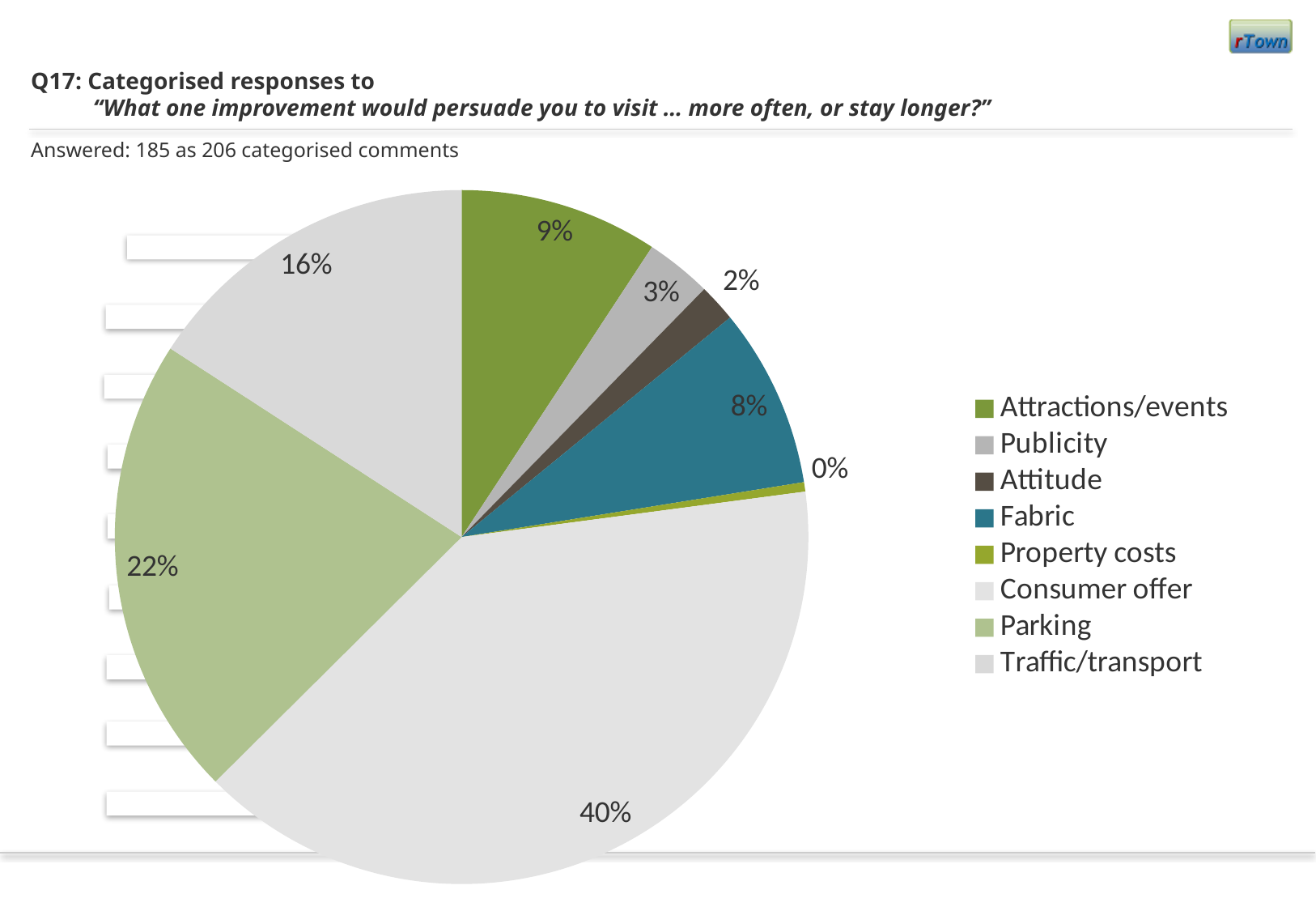
What is the combined share of Parking and Traffic/transport? 38% Which category has the largest slice of the pie? Consumer offer What percentage is shown for Fabric? 8% What is the difference in percentage points between Consumer offer and Parking? 18 What share of the pie does Consumer offer account for? 40% Which is larger, the share for Attractions/events or the share for Fabric? Attractions/events What percentage is shown for Attitude? 2% What kind of chart is shown on the slide? Pie chart Which category has the smallest slice of the pie? Property costs How many categories does the legend list? 8 What percentage is shown for Traffic/transport? 16% What percentage is shown for Parking? 22%